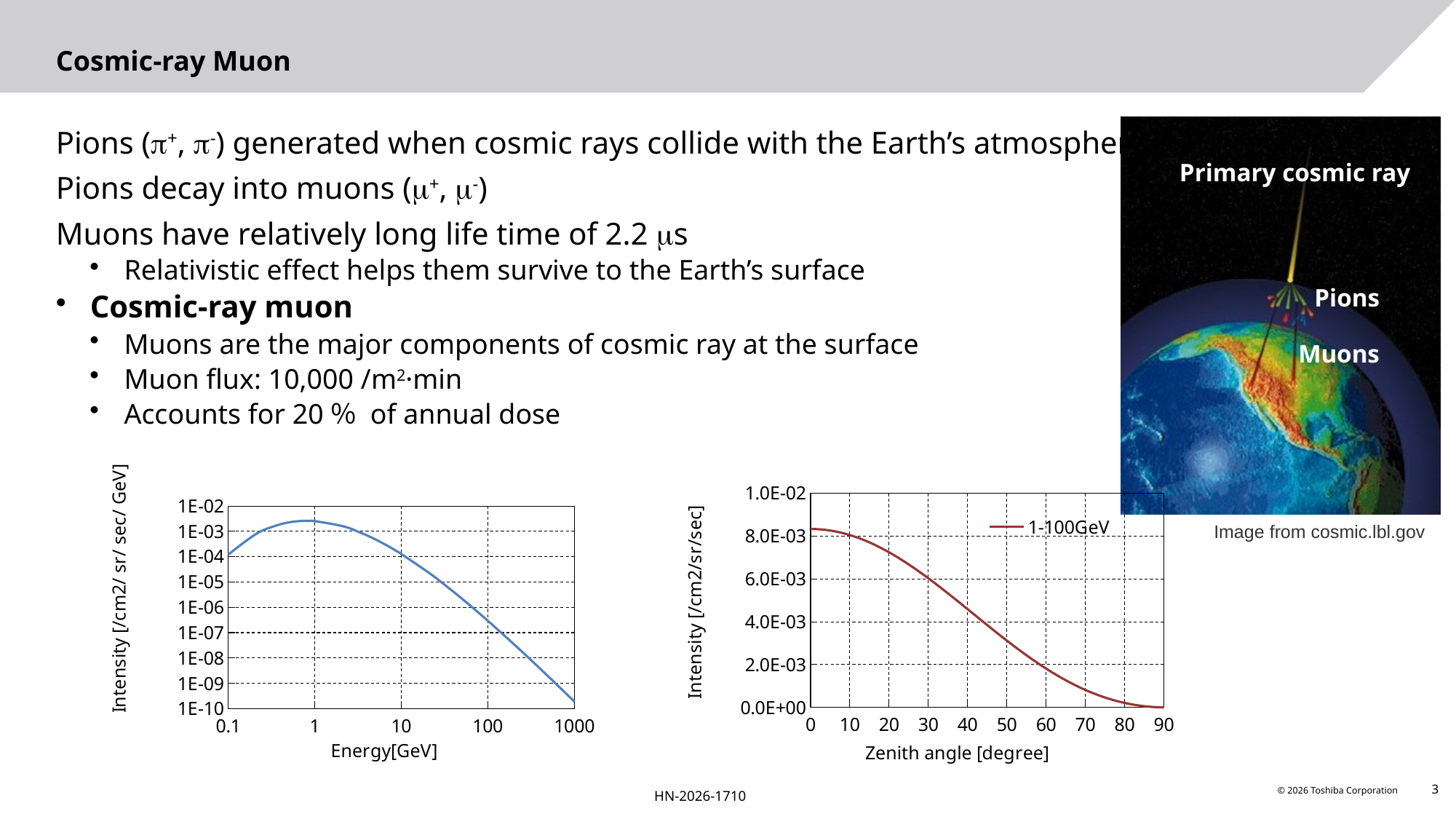
In the left chart, is the intensity at 1 GeV greater or less than 1E-04? greater In the right chart, is the intensity at a zenith angle of 70 degrees greater or less than 2.0E-03? less In the right chart, is the intensity at a zenith angle of 0 degrees greater or less than 6.0E-03? greater In the right chart, what is the legend entry for the plotted series? 1-100GeV What kind of chart is the left chart (Intensity vs Energy)? line chart In the right chart, how many series does the legend list? 1 What is the x-axis label of the left chart? Energy[GeV] What kind of chart is the right chart (Intensity vs Zenith angle)? line chart In the left chart, does the intensity rise or fall as energy increases from 10 GeV to 1000 GeV? fall In the right chart, does the intensity rise or fall as the zenith angle increases from 0 to 90 degrees? fall In the right chart, how many tick labels are shown on the zenith angle axis? 10